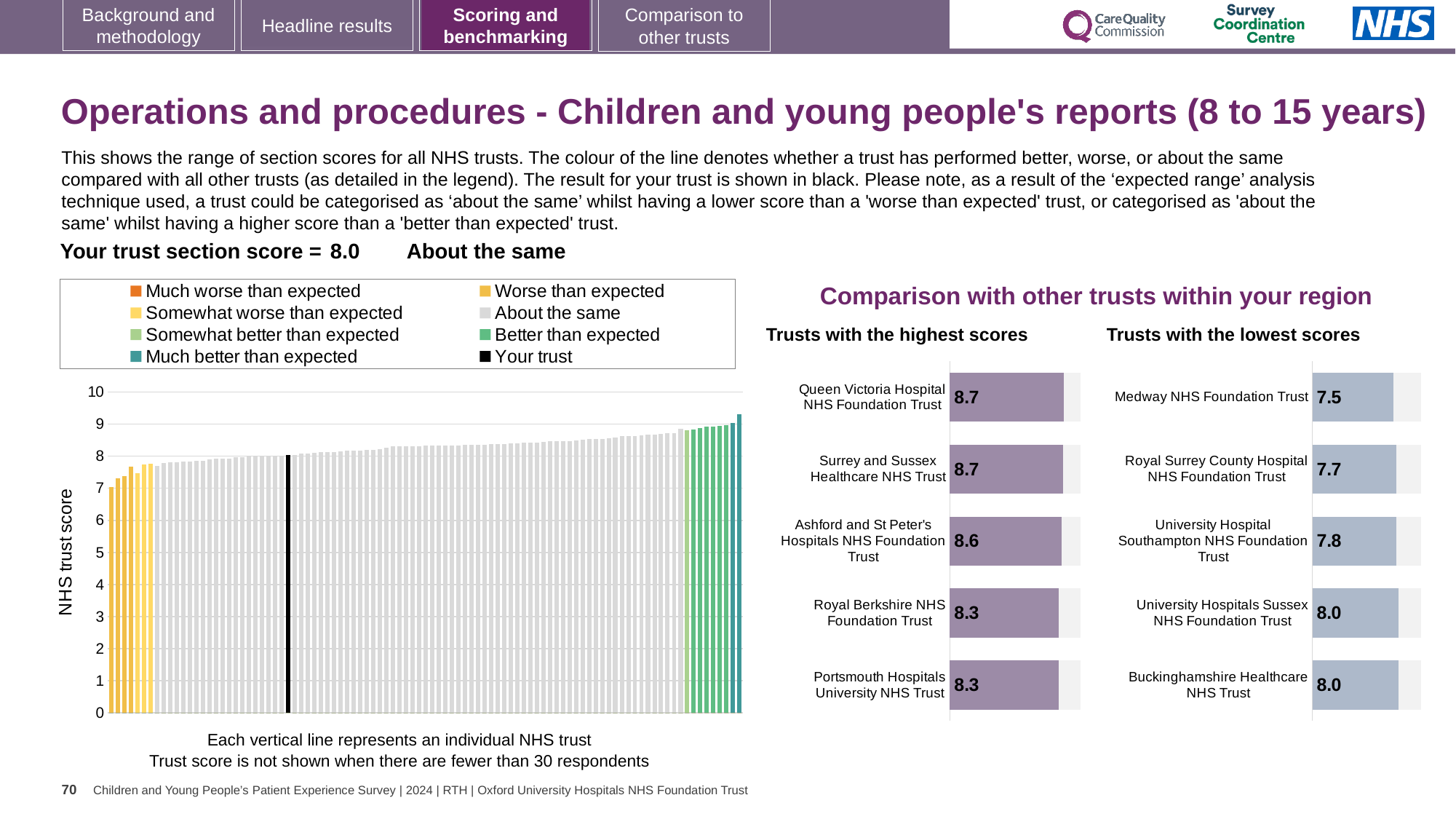
How many entries does the legend of the 'NHS trust score' chart on the left list? 8 In the 'Trusts with the highest scores' chart, what is the difference between the scores of Queen Victoria Hospital NHS Foundation Trust and Portsmouth Hospitals University NHS Trust? 0.4 In the 'NHS trust score' chart on the left, is the value of the tallest bar greater or less than 8? greater How many trusts are listed in the 'Trusts with the highest scores' chart? 5 In the 'Trusts with the highest scores' chart, what is the score for Queen Victoria Hospital NHS Foundation Trust? 8.7 What kind of chart is the 'NHS trust score' chart on the left of the slide? Bar chart In the 'Trusts with the lowest scores' chart, what is the score for Medway NHS Foundation Trust? 7.5 In the 'Trusts with the lowest scores' chart, what is the difference between the scores of Buckinghamshire Healthcare NHS Trust and Medway NHS Foundation Trust? 0.5 In the 'Trusts with the lowest scores' chart, which has the higher score: Royal Surrey County Hospital NHS Foundation Trust or University Hospital Southampton NHS Foundation Trust? University Hospital Southampton NHS Foundation Trust In the 'Trusts with the highest scores' chart, what is the score for Royal Berkshire NHS Foundation Trust? 8.3 In the 'Trusts with the lowest scores' chart, which trust has the lowest score? Medway NHS Foundation Trust In the 'NHS trust score' chart on the left, do the bar values rise or fall from left to right? Rise